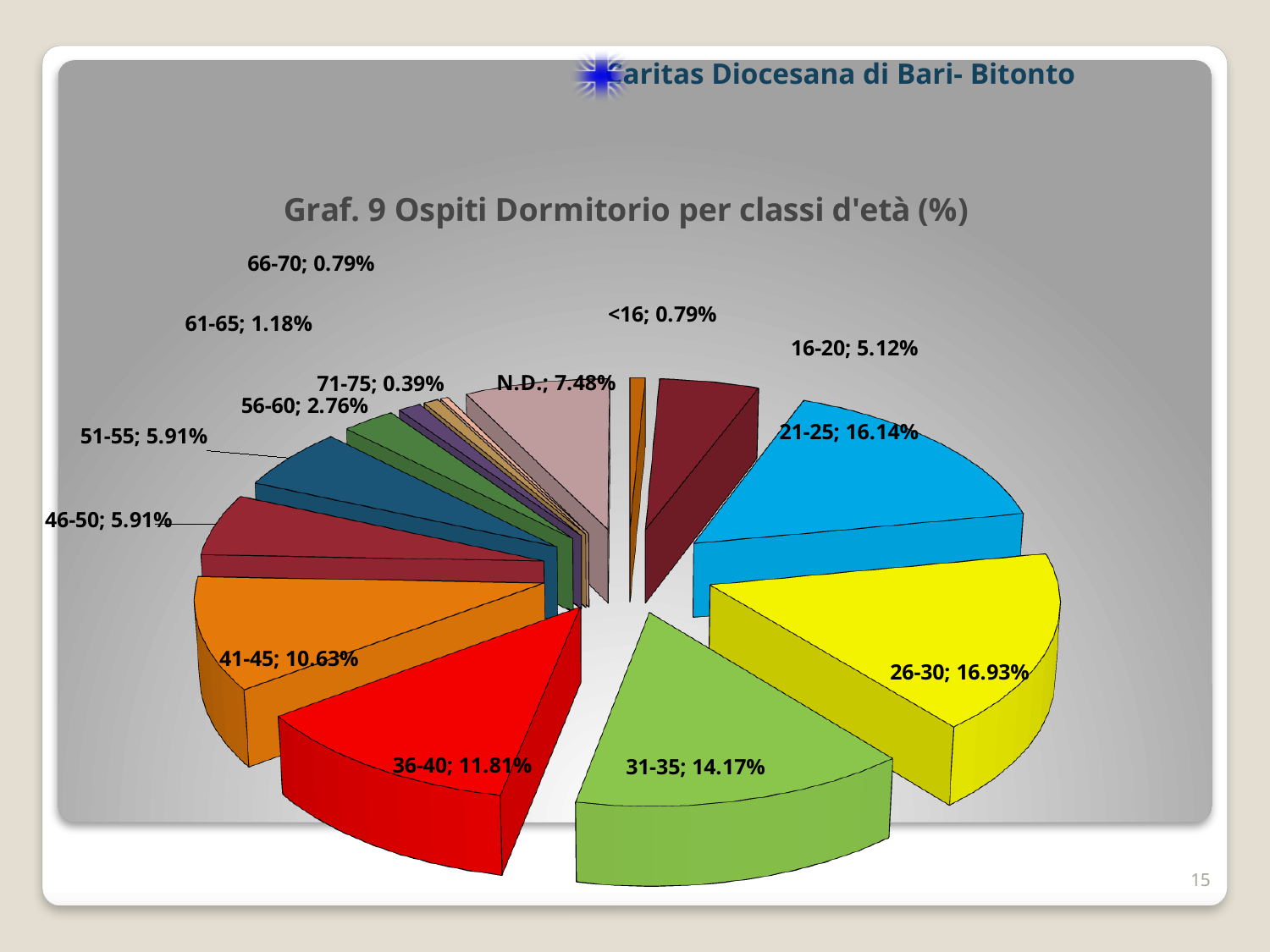
What is the value shown for the 41-45 age class? 10.63% Which has a larger share, the 21-25 age class or the 31-35 age class? 21-25 Which age class has the largest share of the pie? 26-30 What is the difference between the shares of the 36-40 and 41-45 age classes? 1.18% What is the title of the chart? Graf. 9 Ospiti Dormitorio per classi d'età (%) What is the value shown for the 56-60 age class? 2.76% What type of chart is shown on the slide? pie chart How many slices does the pie chart have? 14 What is the value shown for the N.D. slice? 7.48% What is the difference between the shares of the 26-30 and 21-25 age classes? 0.79% What percentage of the pie does the 26-30 age class represent? 16.93% Which age class has the smallest share of the pie? 71-75